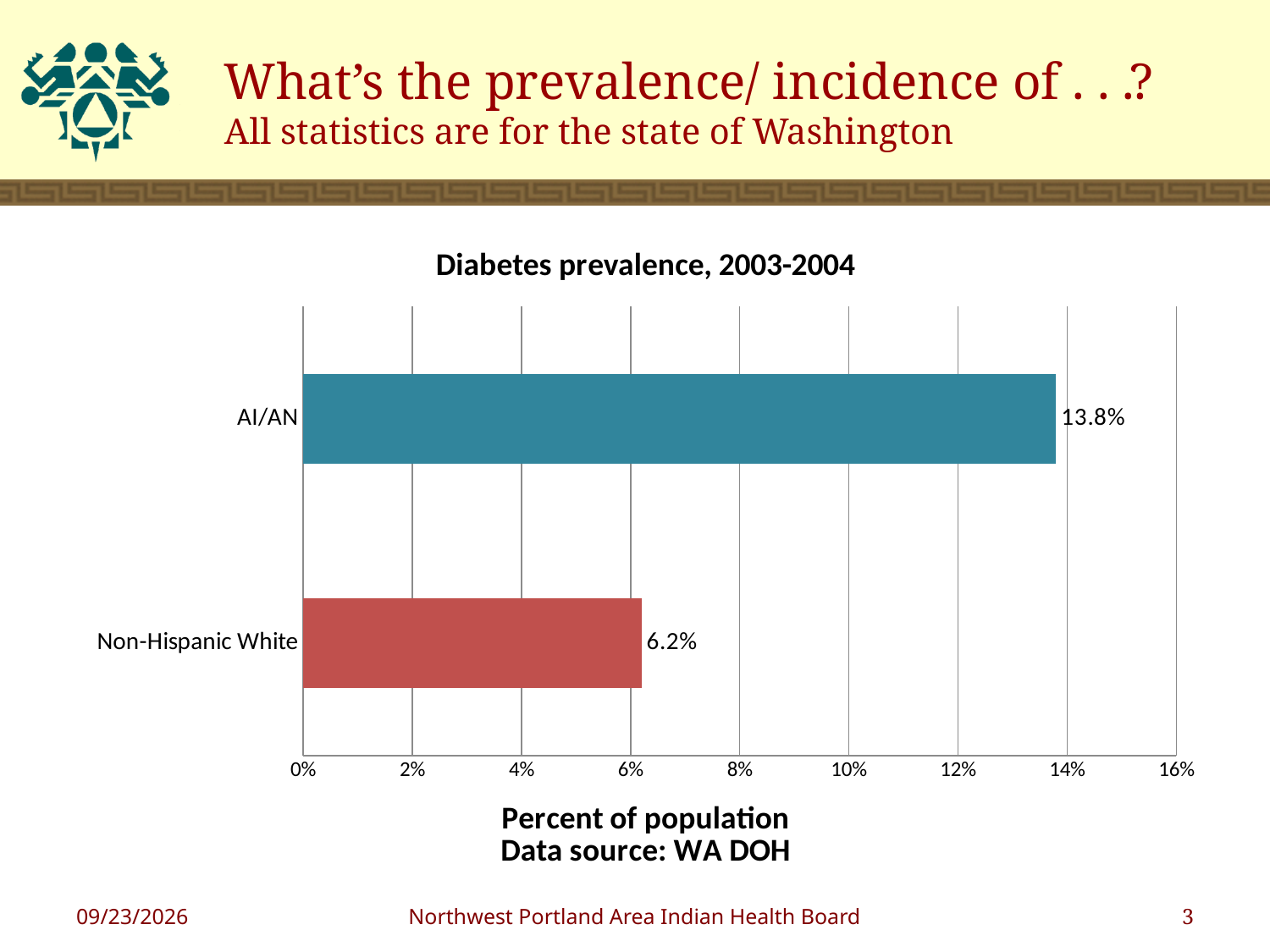
What is the difference in diabetes prevalence between AI/AN and Non-Hispanic White? 7.6% Is the diabetes prevalence for AI/AN greater or less than 12%? greater Which category has the lowest diabetes prevalence? Non-Hispanic White What is the diabetes prevalence for Non-Hispanic White? 6.2% What is the data source stated below the chart? WA DOH Which category has the highest diabetes prevalence? AI/AN What is the title of the chart? Diabetes prevalence, 2003-2004 What kind of chart is shown on the slide? Bar chart What is the diabetes prevalence for AI/AN? 13.8% Which has a higher diabetes prevalence, AI/AN or Non-Hispanic White? AI/AN Is the diabetes prevalence for Non-Hispanic White greater or less than 8%? less How many categories are shown in the chart? 2